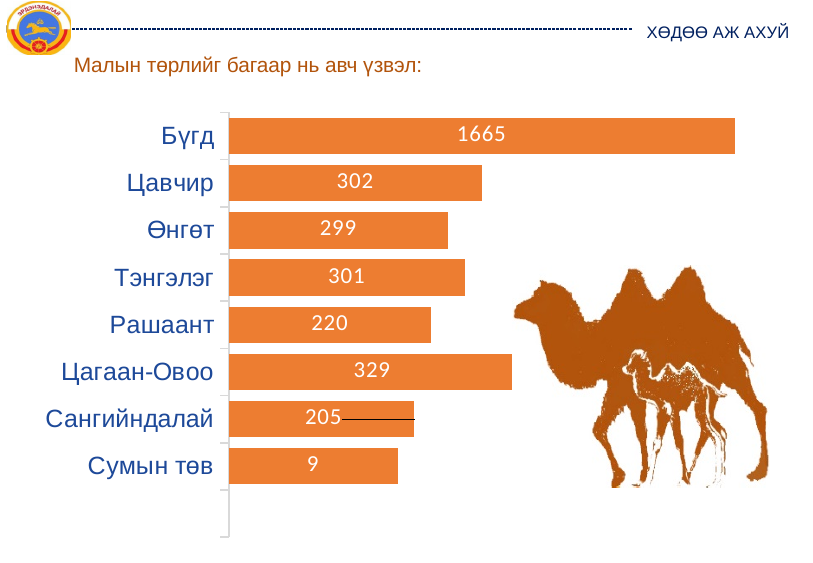
Excluding Бүгд, which category has the highest value? Цагаан-Овоо What type of chart is shown on the slide? bar chart What is the value for Рашаант? 220 How many categories are shown in the chart? 8 What is the title text above the chart? Малын төрлийг багаар нь авч үзвэл: What is the value for Тэнгэлэг? 301 What is the value for Бүгд? 1665 Which category has the highest value? Бүгд What is the difference between the values for Цагаан-Овоо and Цавчир? 27 What is the value for Цагаан-Овоо? 329 Which is larger, the value for Рашаант or the value for Сангийндалай? Рашаант What is the value for Сангийндалай? 205